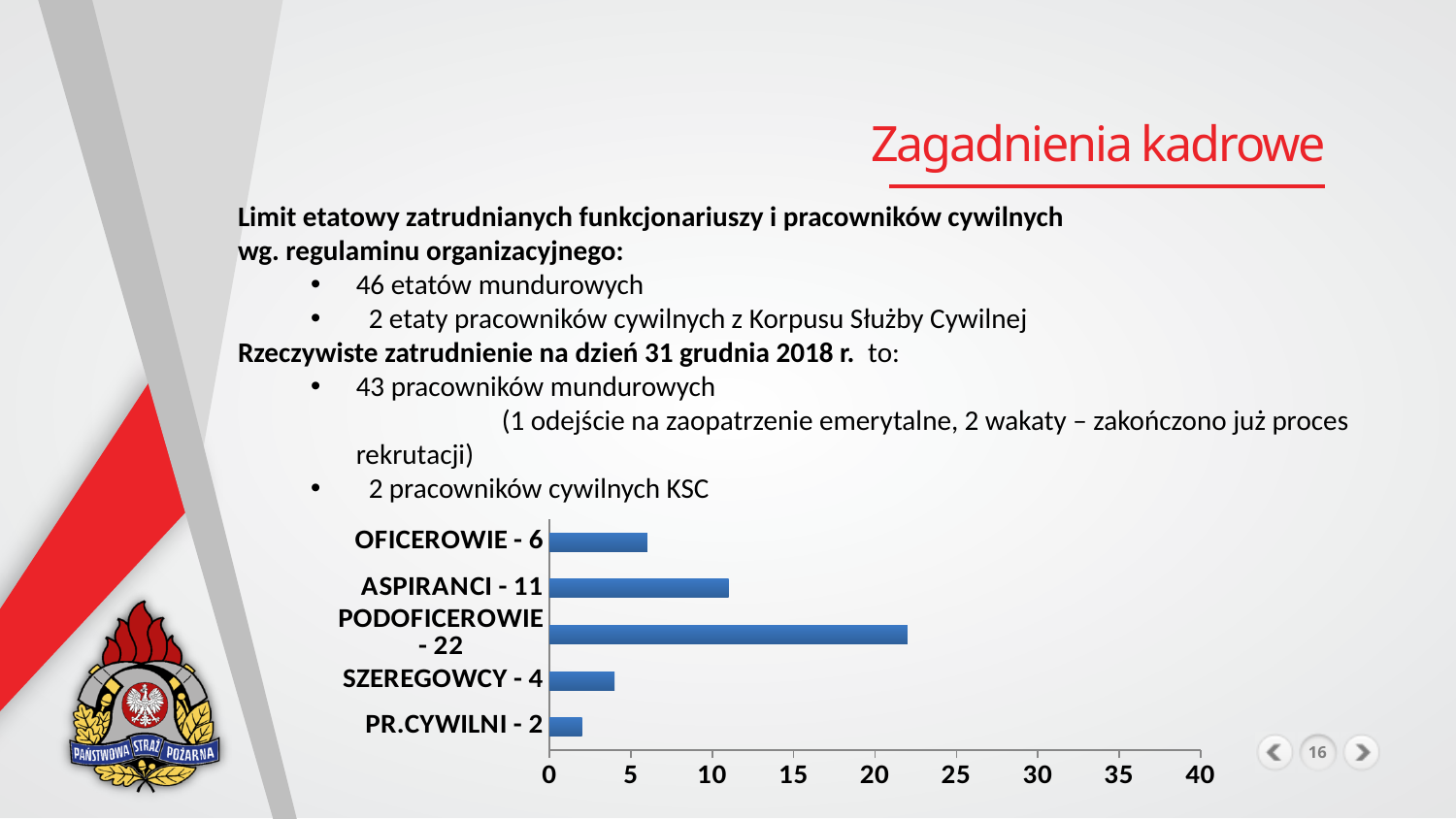
What is the value for PODOFICEROWIE? 22 What kind of chart is shown on the slide? bar chart Which category has the lowest value? PR.CYWILNI What is the difference between the values for PODOFICEROWIE and ASPIRANCI? 11 What is the difference between the values for OFICEROWIE and SZEREGOWCY? 2 Is the value for PODOFICEROWIE greater or less than 20? greater Which is larger, the value for OFICEROWIE or the value for SZEREGOWCY? OFICEROWIE Which category has the highest value? PODOFICEROWIE What is the value for ASPIRANCI? 11 What is the value for PR.CYWILNI? 2 How many categories are shown in the chart? 5 What is the highest value shown on the chart's horizontal axis? 40